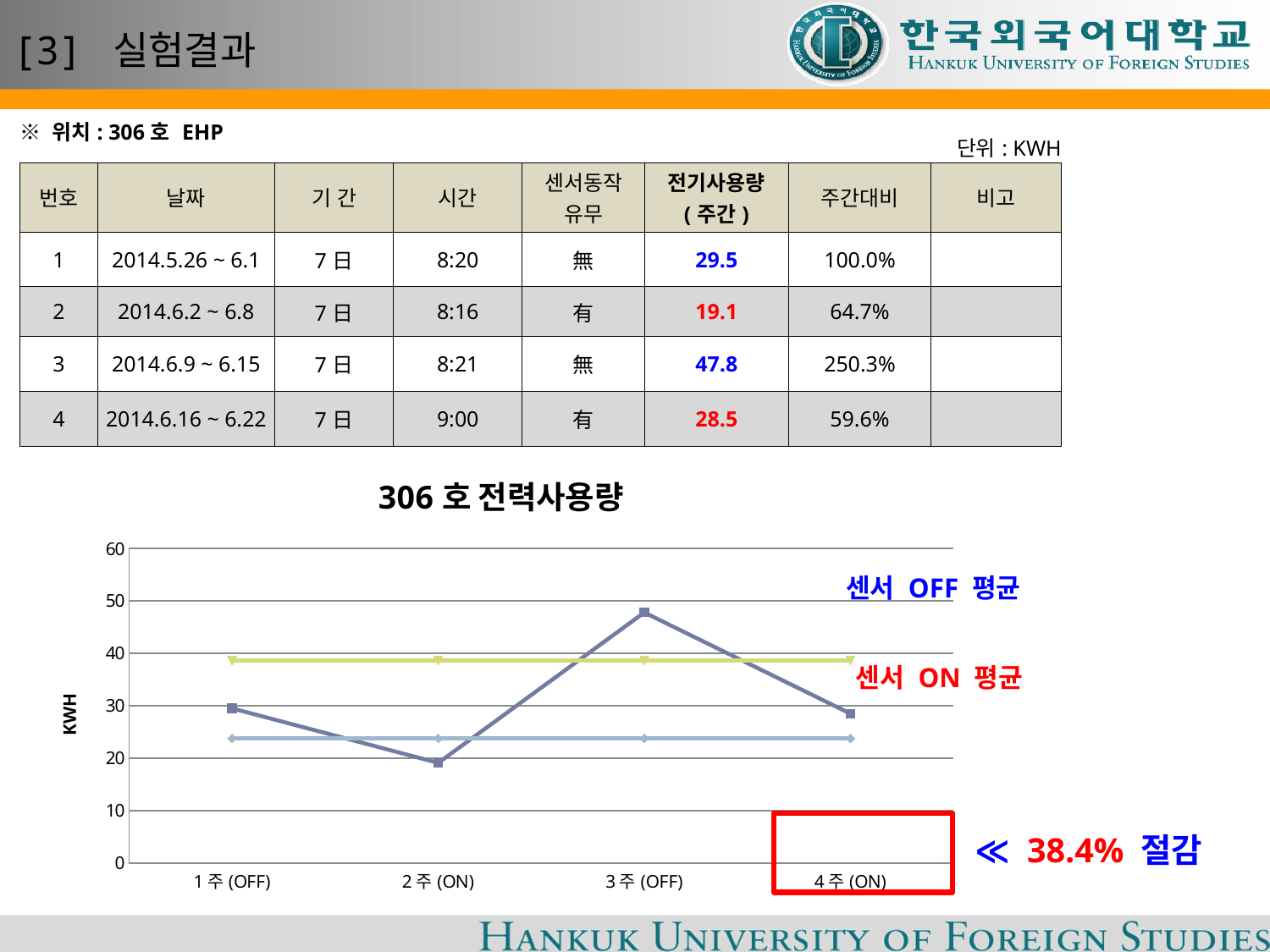
In the 306 호 전력사용량 chart, does the power usage rise or fall from 2주 (ON) to 3주 (OFF)? rise What kind of chart is shown under the title 306 호 전력사용량? line chart How many categories are shown on the x axis of the 306 호 전력사용량 chart? 4 In the 306 호 전력사용량 chart, which week has the highest power usage? 3주 (OFF) In the 306 호 전력사용량 chart, is the value for 4주 (ON) greater or less than 40? less In the 306 호 전력사용량 chart, which is larger, the value for 1주 (OFF) or 3주 (OFF)? 3주 (OFF) In the 306 호 전력사용량 chart, is the 센서 ON 평균 line greater or less than 30? less What is the title of the line chart on the slide? 306 호 전력사용량 In the 306 호 전력사용량 chart, is the value for 2주 (ON) greater or less than 30? less In the 306 호 전력사용량 chart, which week has the lowest power usage? 2주 (ON)